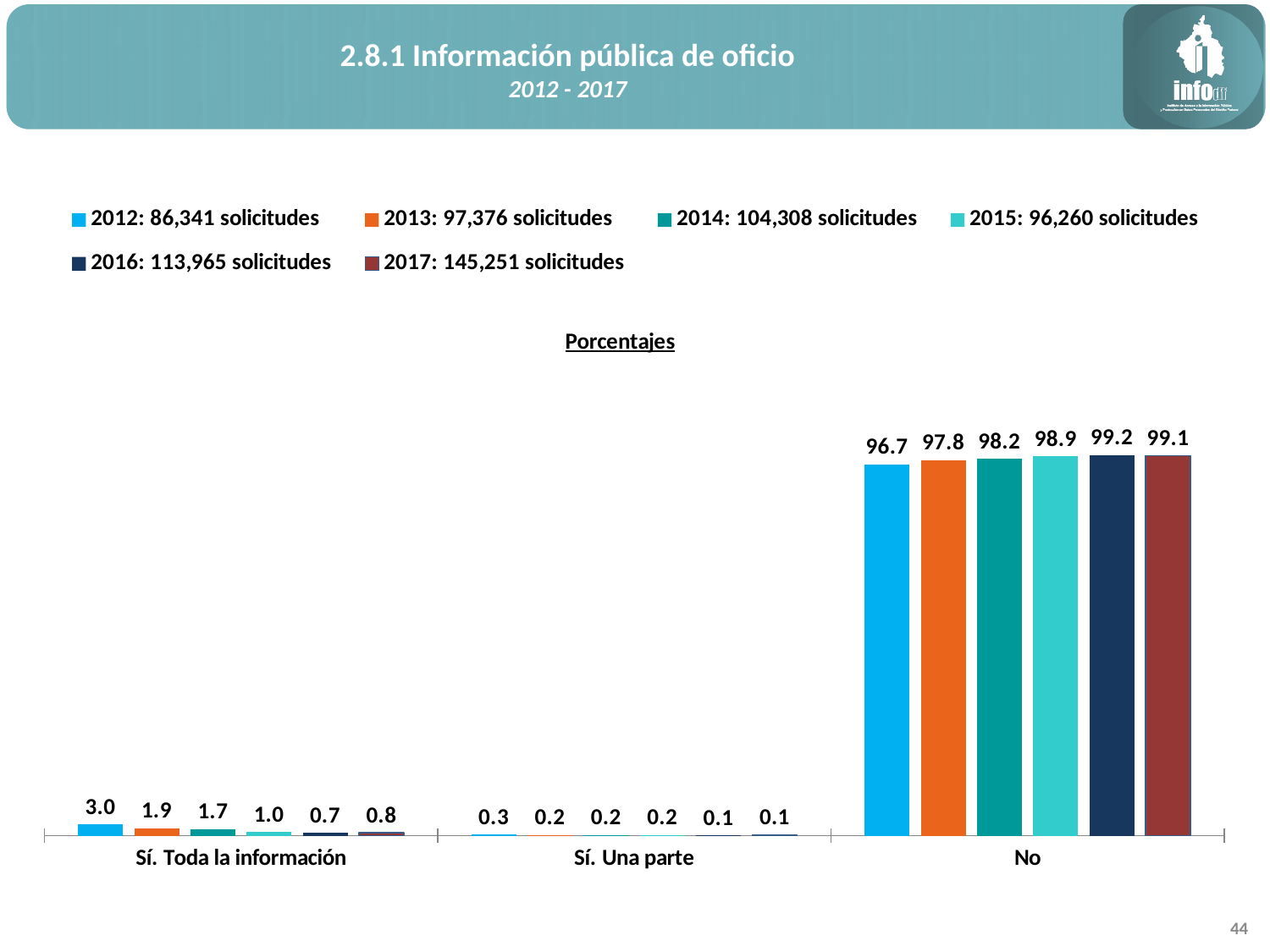
What is the value for 2015 in the 'Sí. Una parte' category? 0.2 How many series does the legend list? 6 According to the legend, how many solicitudes were there in 2017? 145,251 Which year has the lowest value in the 'No' category? 2012 What is the value for 2017 in the 'Sí. Toda la información' category? 0.8 What is the difference between the 2017 and 2012 values in the 'No' category? 2.4 Do the values in the 'Sí. Toda la información' category generally rise or fall from 2012 to 2017? fall Which is larger in the 'Sí. Toda la información' category: the value for 2013 or the value for 2014? 2013 Which year has the highest value in the 'Sí. Toda la información' category? 2012 What kind of chart is shown on the slide? bar chart What is the value for 2012 in the 'No' category? 96.7 How many categories are shown on the x axis? 3